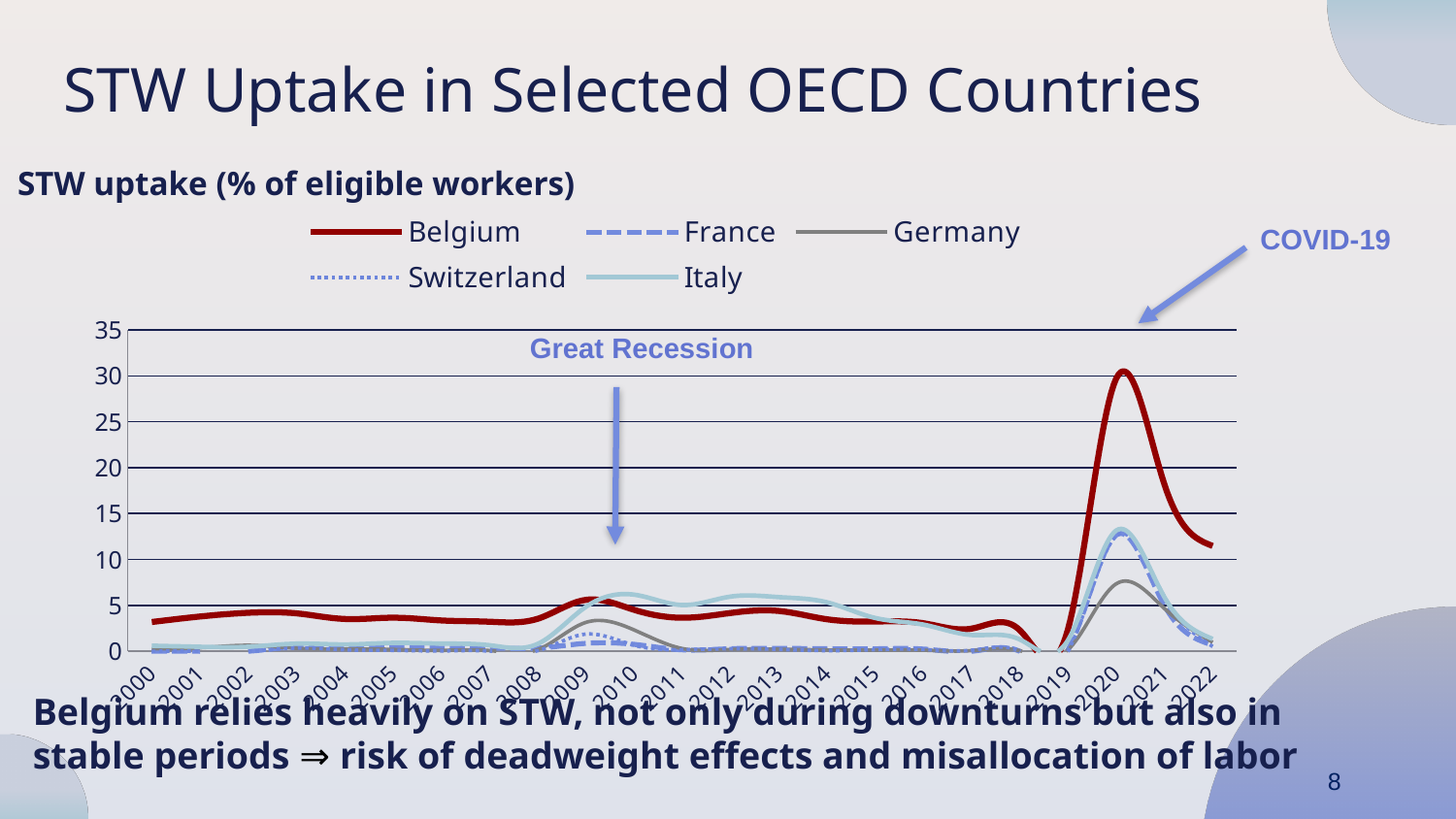
How many years are labelled on the x axis? 23 Is the value for Belgium in 2020 greater or less than 25? greater Which country has the highest STW uptake in 2020? Belgium Which is larger in 2005, the value for Belgium or the value for France? Belgium Is the value for Italy in 2020 greater or less than 10? greater What is the title of the chart? STW uptake (% of eligible workers) Does the value for Belgium rise or fall from 2020 to 2022? fall Is the value for Germany in 2020 greater or less than 10? less Which two events are annotated on the chart? Great Recession and COVID-19 Which is larger in 2020, the value for Italy or the value for Germany? Italy How many series does the legend list? 5 What kind of chart is shown on the slide? line chart